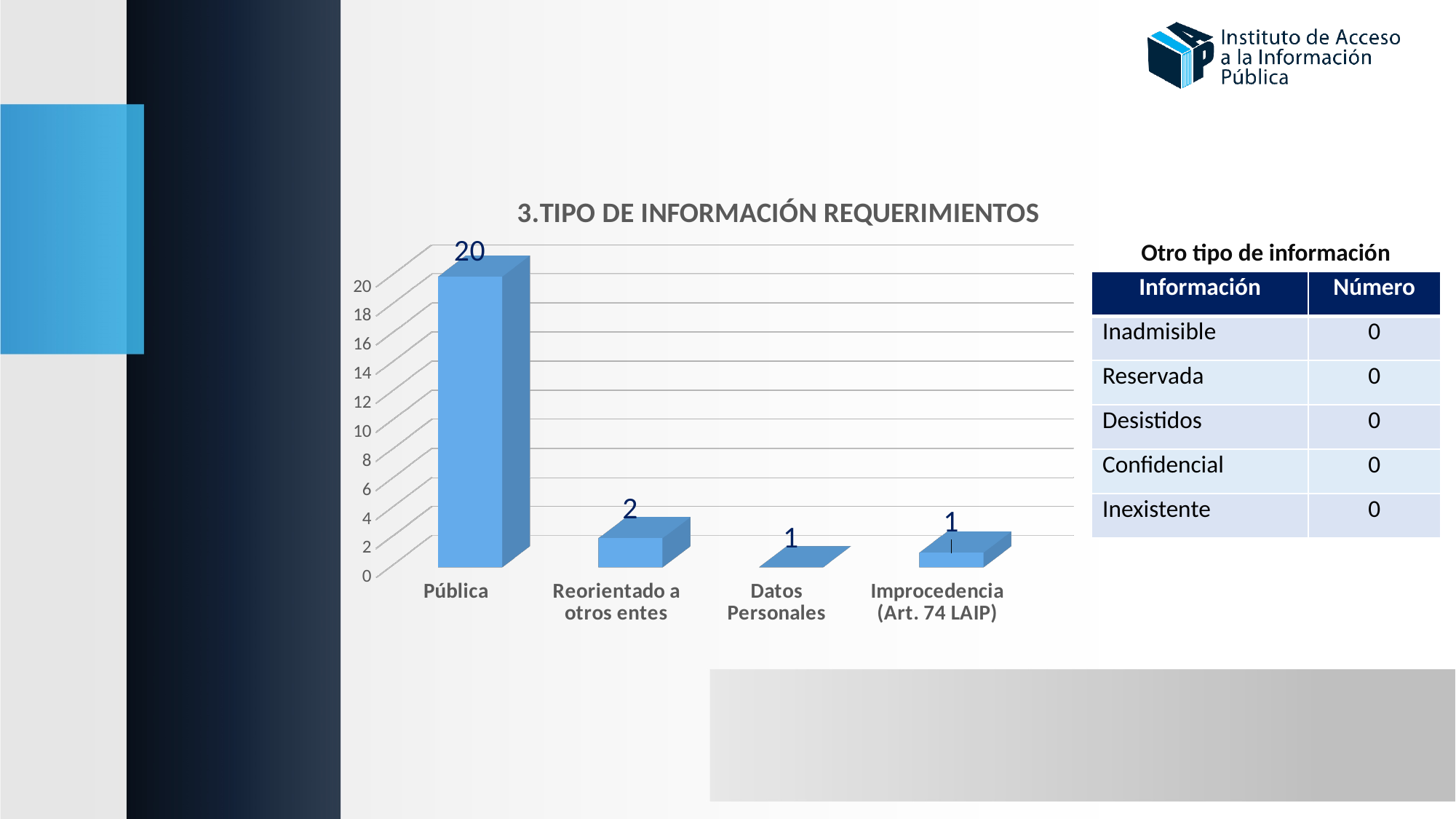
What kind of chart is shown? bar chart What is the title of the chart? 3.TIPO DE INFORMACIÓN REQUERIMIENTOS Is the value for Pública greater or less than 10? greater What is the value for Improcedencia (Art. 74 LAIP)? 1 What is the value for Pública? 20 What is the value for Reorientado a otros entes? 2 Which category has the highest value? Pública What is the difference between the values for Reorientado a otros entes and Datos Personales? 1 Which is larger, the value for Pública or the value for Reorientado a otros entes? Pública What is the value for Datos Personales? 1 How many categories are shown on the x axis? 4 What is the difference between the values for Pública and Reorientado a otros entes? 18